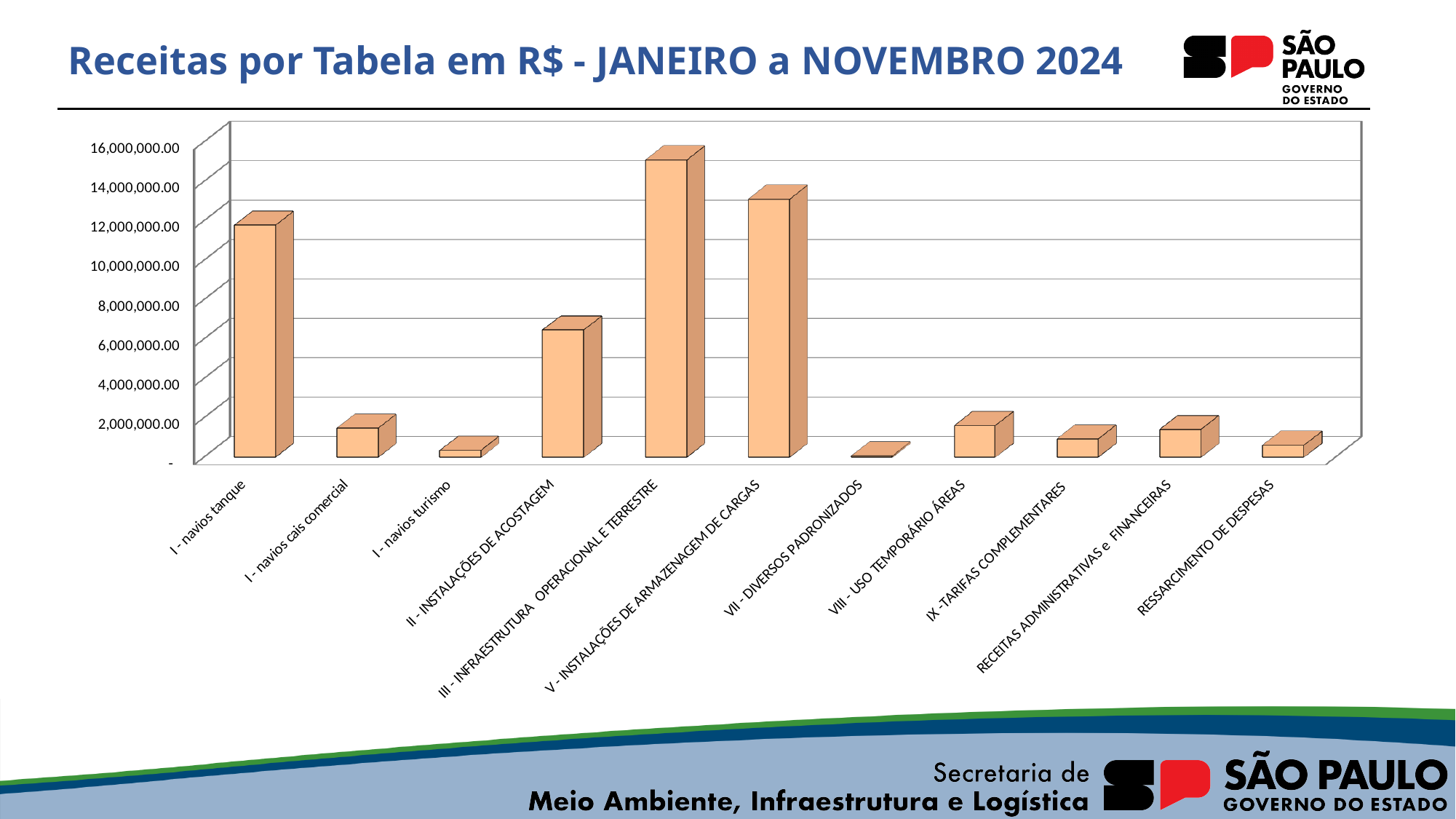
How many categories are plotted on the chart? 11 Is the value for II - INSTALAÇÕES DE ACOSTAGEM greater or less than 8,000,000.00? less Which category has the highest value on the chart? III - INFRAESTRUTURA OPERACIONAL E TERRESTRE Is the value for I - navios cais comercial greater or less than 2,000,000.00? less Which is larger, the value for III - INFRAESTRUTURA OPERACIONAL E TERRESTRE or the value for V - INSTALAÇÕES DE ARMAZENAGEM DE CARGAS? III - INFRAESTRUTURA OPERACIONAL E TERRESTRE Which is larger, the value for I - navios turismo or the value for VIII - USO TEMPORÁRIO ÁREAS? VIII - USO TEMPORÁRIO ÁREAS Which category has the lowest value on the chart? VII - DIVERSOS PADRONIZADOS Is the value for V - INSTALAÇÕES DE ARMAZENAGEM DE CARGAS greater or less than 12,000,000.00? greater What is the title of the chart on the slide? Receitas por Tabela em R$ - JANEIRO a NOVEMBRO 2024 Which is larger, the value for I - navios tanque or the value for II - INSTALAÇÕES DE ACOSTAGEM? I - navios tanque What kind of chart is shown on the slide? Bar chart